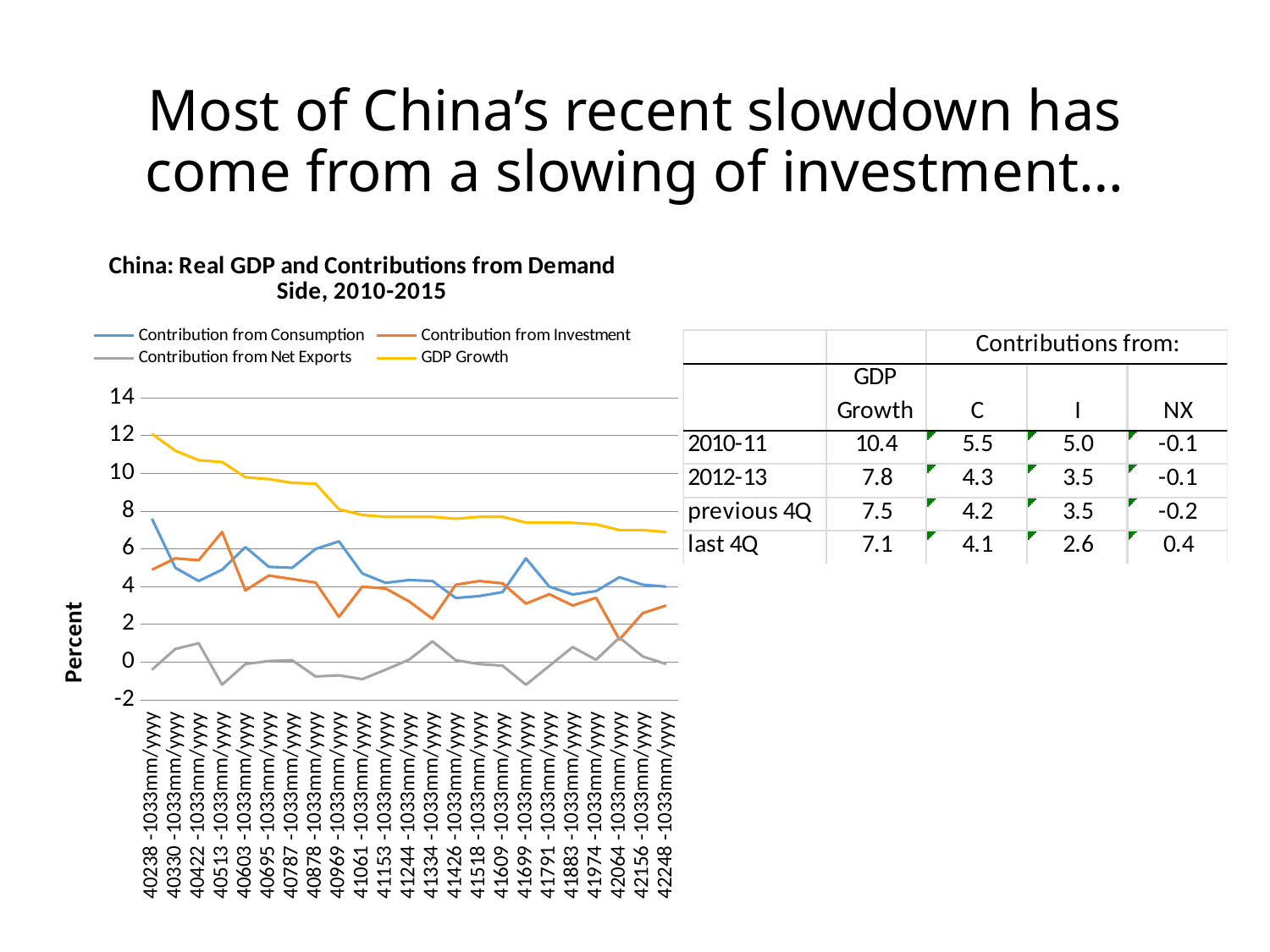
What is the title of the chart? China: Real GDP and Contributions from Demand Side, 2010-2015 How many series does the chart legend list? 4 Does the GDP Growth line rise or fall along the x axis? fall Is the GDP Growth value at the last point (42248) greater or less than 8? less Is the Contribution from Investment value at 42064 greater or less than 2? less What type of chart is shown on the slide? line chart Is the Contribution from Consumption value at the first point (40238) greater or less than 6? greater Which series has the highest values across the chart? GDP Growth Which series has the lowest values across the chart? Contribution from Net Exports At the first point (40238), which is larger: Contribution from Consumption or Contribution from Investment? Contribution from Consumption What is the label on the vertical axis of the chart? Percent